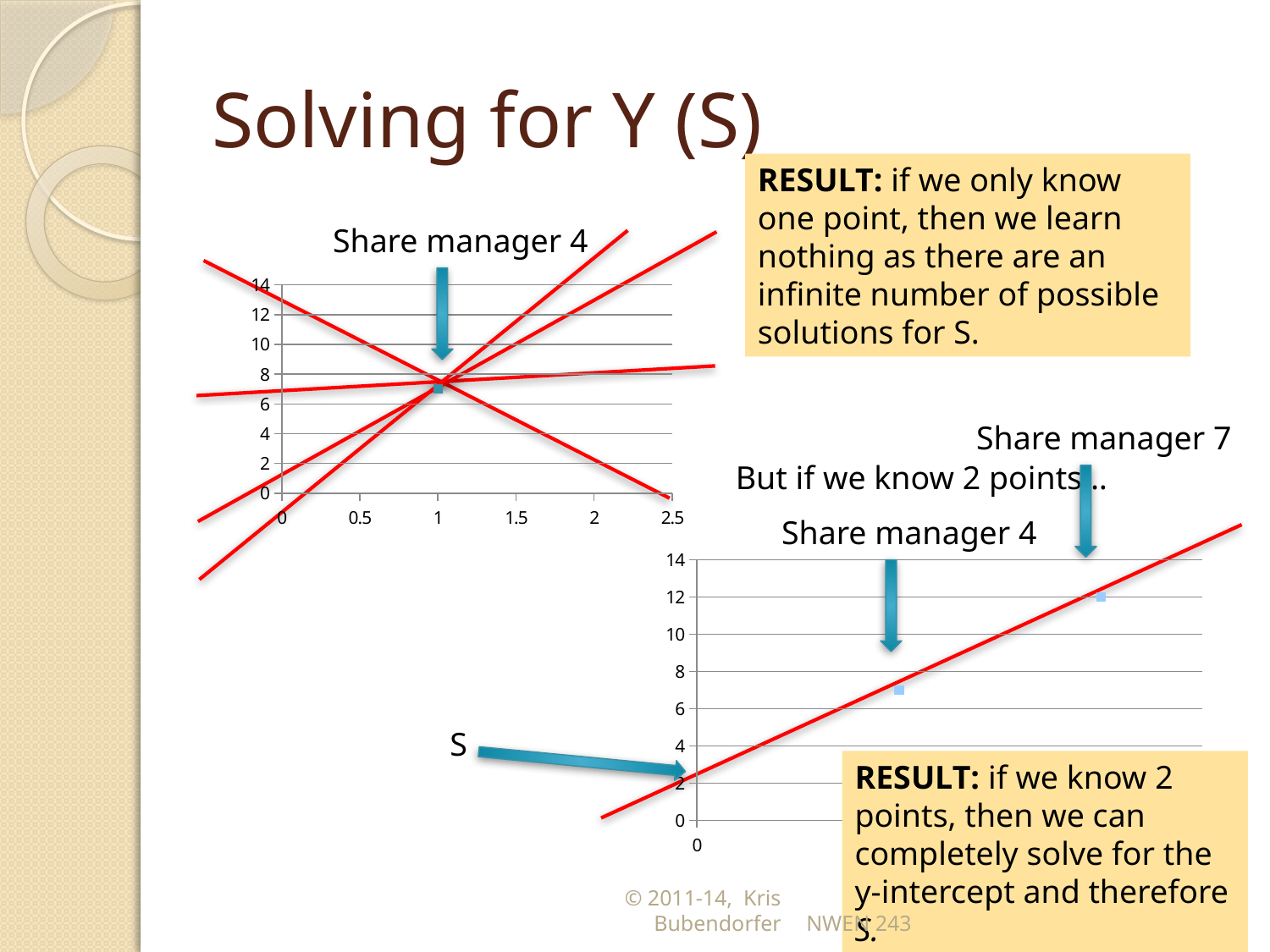
On the right chart, is the value of the point labelled Share manager 7 greater or less than 10? greater How many data points are plotted on the left chart? 1 How many data points are plotted on the right chart? 2 On the left chart, is the value of the plotted point greater or less than 6? greater On the left chart, is the value of the plotted point greater or less than 8? less What kind of chart is the chart on the left of the slide? scatter chart What kind of chart is the chart on the right of the slide? scatter chart What is the highest value shown on the y axis of the left chart? 14 On the right chart, which point has the higher value, Share manager 4 or Share manager 7? Share manager 7 On the right chart, do the plotted values rise or fall as you move along the x axis? rise What is the largest tick value shown on the x axis of the left chart? 2.5